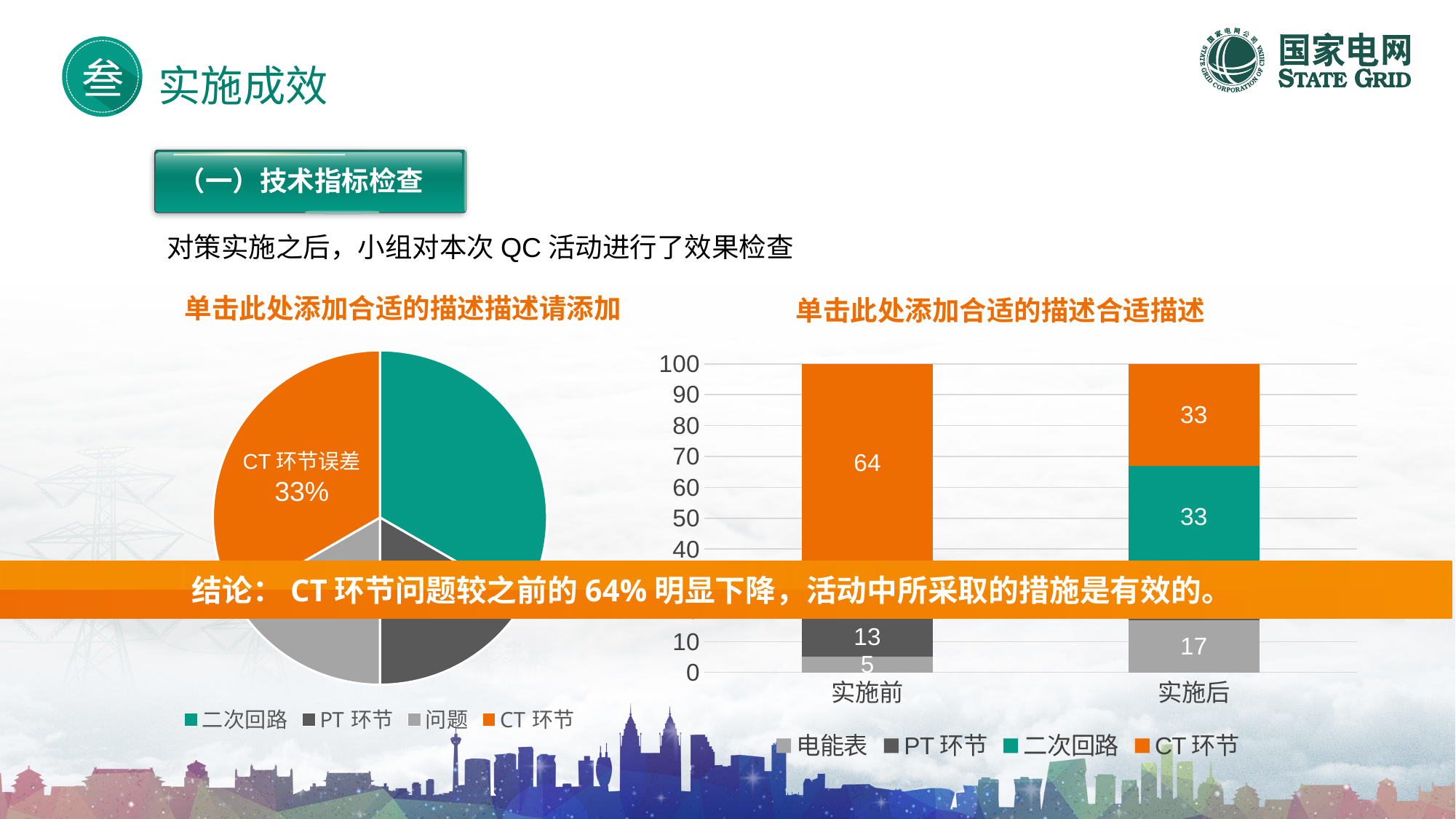
In the bar chart on the right, what is the value of CT 环节 for 实施后? 33 In the bar chart on the right, what is the value of PT 环节 for 实施前? 13 In the bar chart on the right, does the CT 环节 value rise or fall from 实施前 to 实施后? fall In the pie chart on the left, which slice is larger, 二次回路 or PT 环节? 二次回路 In the bar chart on the right, what is the value of 电能表 for 实施后? 17 In the pie chart on the left, what share is labelled for CT 环节误差? 33% In the bar chart on the right, by how much does the CT 环节 value for 实施前 exceed the CT 环节 value for 实施后? 31 How many categories are shown on the x axis of the bar chart on the right? 2 How many entries does the legend of the pie chart on the left list? 4 In the bar chart on the right, what is the value of CT 环节 for 实施前? 64 What kind of chart is the chart on the left of the slide? pie chart What kind of chart is the chart on the right of the slide? bar chart